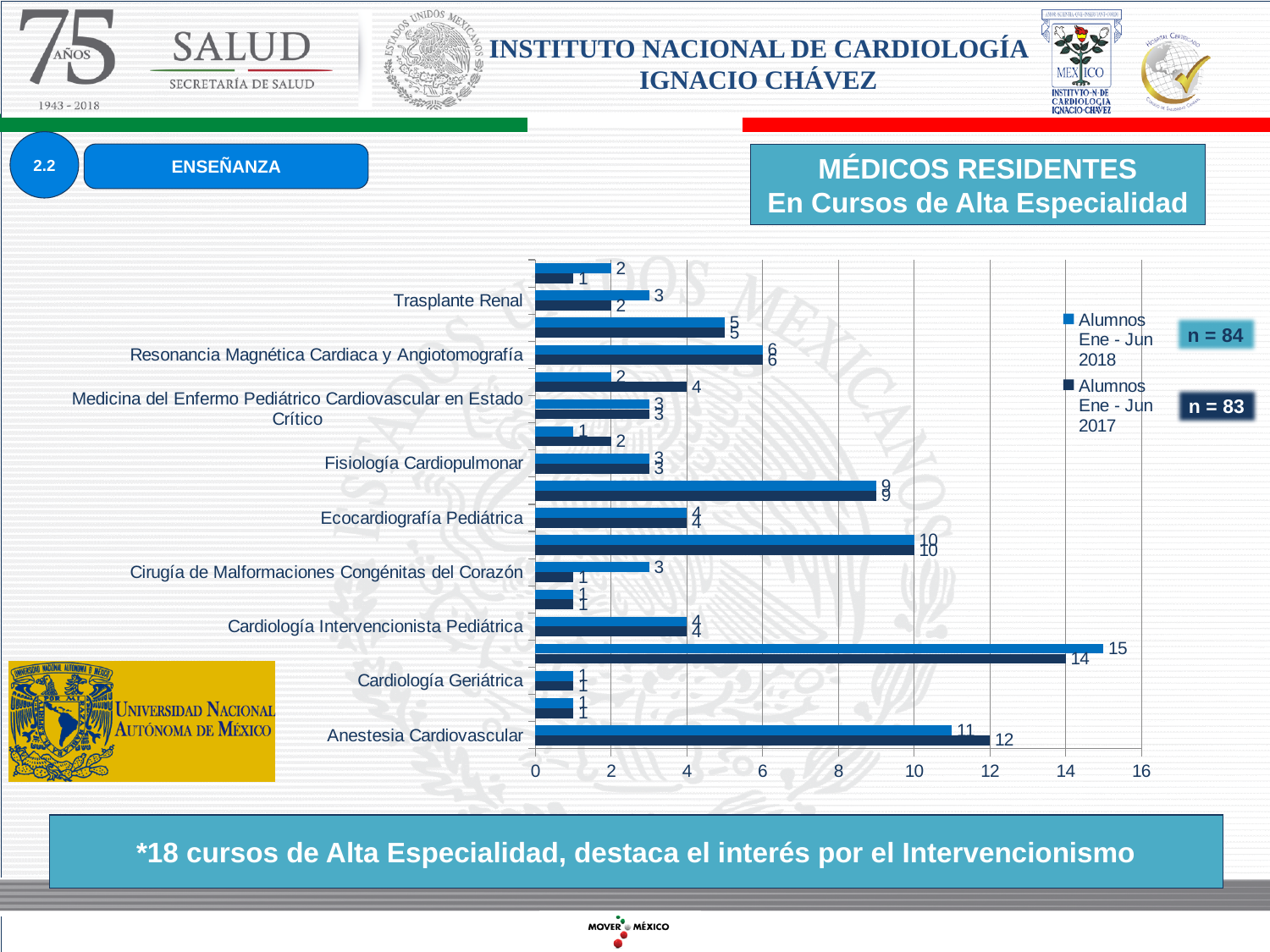
What is the value for Resonancia Magnética Cardiaca y Angiotomografía in the Alumnos Ene - Jun 2018 series? 6 What kind of chart is shown on the slide? bar chart What is the value for Trasplante Renal in the Alumnos Ene - Jun 2017 series? 2 What is the value for Anestesia Cardiovascular in the Alumnos Ene - Jun 2018 series? 11 What is the title of the chart? MÉDICOS RESIDENTES En Cursos de Alta Especialidad What is the value for Anestesia Cardiovascular in the Alumnos Ene - Jun 2017 series? 12 What is the value for Cirugía de Malformaciones Congénitas del Corazón in the Alumnos Ene - Jun 2018 series? 3 What n value is shown next to the Alumnos Ene - Jun 2018 legend entry? n = 84 What is the difference between the 2017 and 2018 values for Anestesia Cardiovascular? 1 How many series does the legend list? 2 For Cirugía de Malformaciones Congénitas del Corazón, which series has the larger value, Alumnos Ene - Jun 2018 or Alumnos Ene - Jun 2017? Alumnos Ene - Jun 2018 Is the value for Anestesia Cardiovascular in the Alumnos Ene - Jun 2017 series greater or less than 10? greater